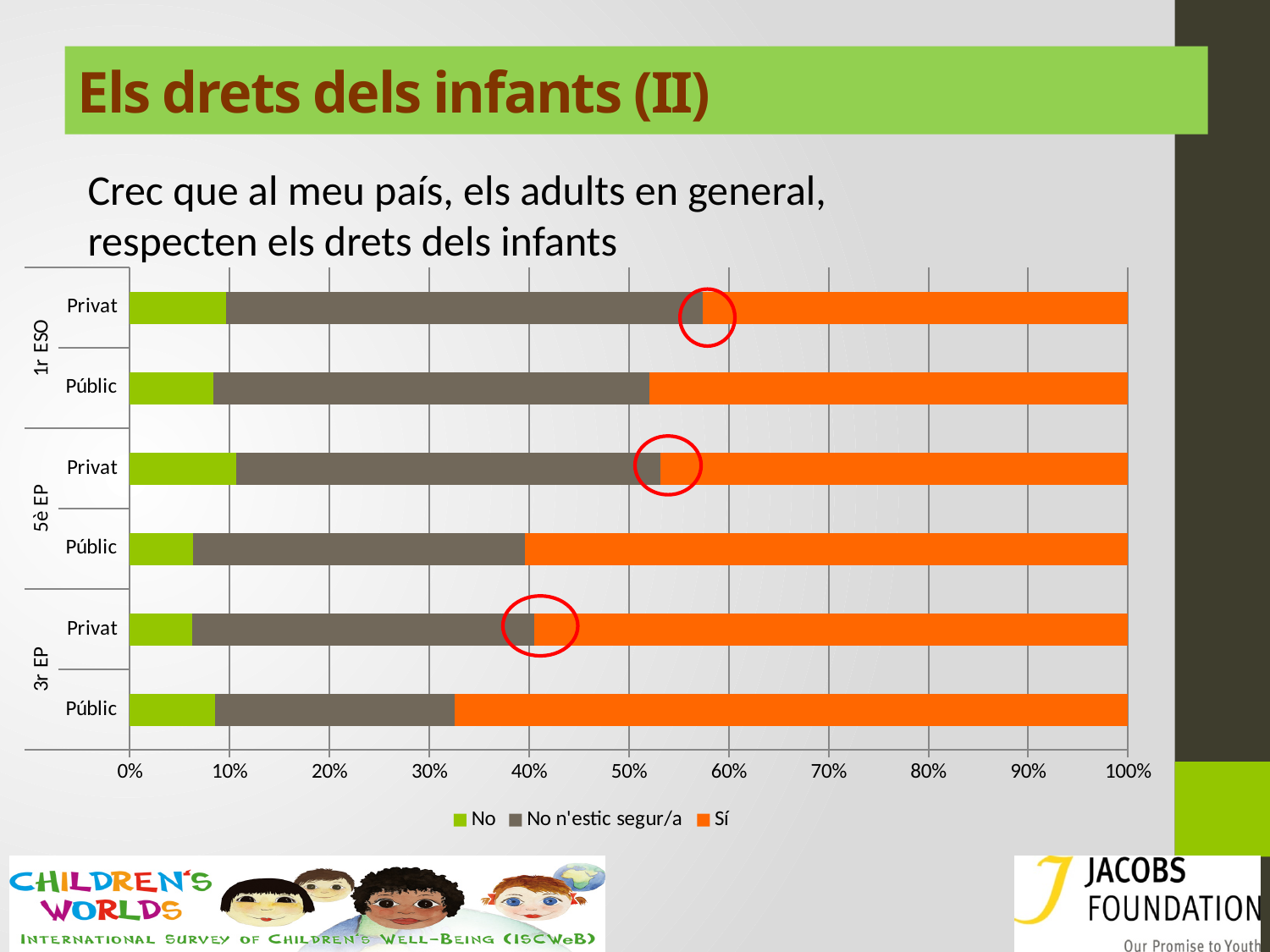
Is the 'Sí' share larger for 5è EP Públic or for 5è EP Privat? 5è EP Públic How many bars are plotted in the chart? 6 What are the three series named in the legend? No, No n'estic segur/a, Sí What kind of chart is shown on the slide? Stacked bar chart For 3r EP Públic, does the 'Sí' segment begin at a point greater or less than 40%? less For 1r ESO Privat, does the 'Sí' segment begin at a point greater or less than 50%? greater What statement is the chart about, as written above it? Crec que al meu país, els adults en general, respecten els drets dels infants Is the 'No' share for 3r EP Privat greater or less than 10%? less Which bar has the smallest 'Sí' share? 1r ESO Privat Is the 'Sí' share larger for 3r EP Públic or for 1r ESO Privat? 3r EP Públic How many series does the chart legend list? 3 Which bar has the largest 'Sí' share? 3r EP Públic